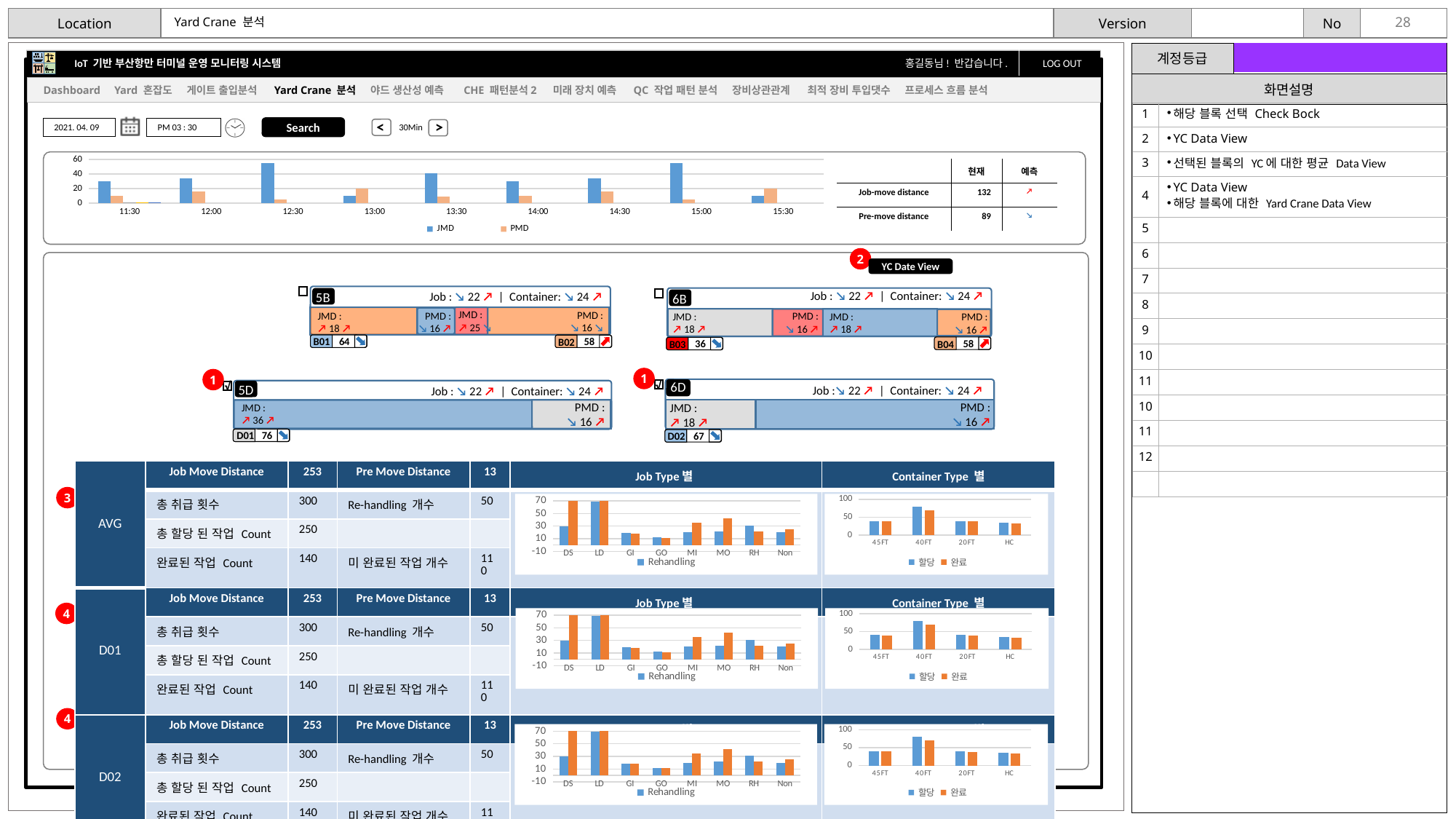
How many time categories are shown on the x axis of the top JMD/PMD chart? 9 In the top JMD/PMD chart, which is larger at 12:00, JMD or PMD? JMD In the top JMD/PMD chart, is the JMD value at 13:00 greater or less than 20? less In the AVG row's 'Job Type 별' chart, is the blue bar for DS greater or less than 50? less In the AVG row's 'Container Type 별' chart, how many series does the legend list? 2 In the top JMD/PMD chart, is the JMD value at 12:30 greater or less than 40? greater What kind of chart is the chart at the top of the slide showing JMD and PMD over time? bar chart In the AVG row's 'Job Type 별' chart, how many categories are on the x axis? 8 In the AVG row's 'Container Type 별' chart, which category has the highest value? 40FT How many series does the legend of the top JMD/PMD chart list? 2 In the AVG row's 'Job Type 별' chart, which category has the lowest values? GO